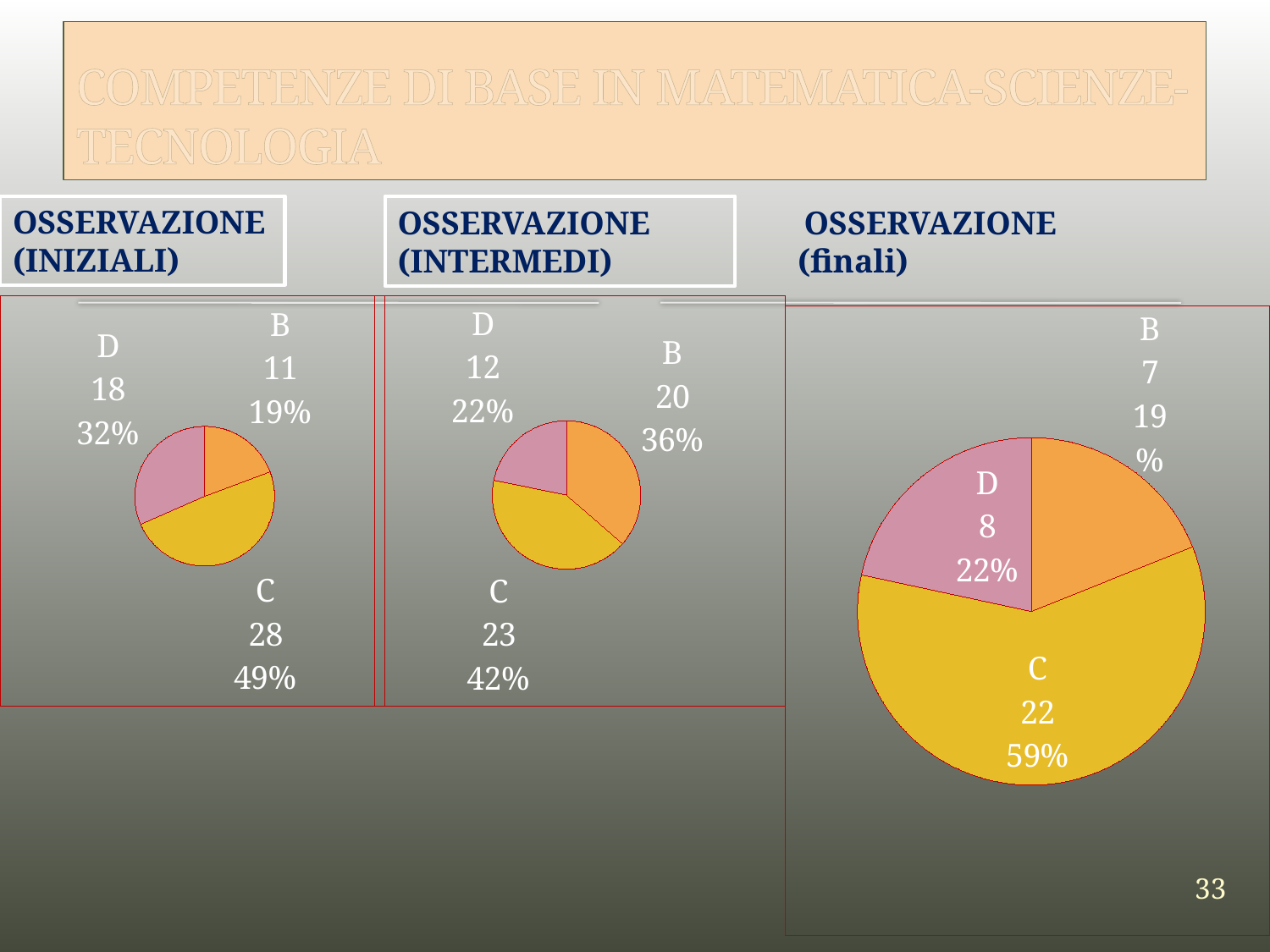
In the OSSERVAZIONE (INTERMEDI) pie chart, which is larger, the value for B or the value for D? B In the OSSERVAZIONE (finali) pie chart, which category has the smallest value? B In the OSSERVAZIONE (INTERMEDI) pie chart, what is the value for category B? 20 In the OSSERVAZIONE (INIZIALI) pie chart, what is the value for category C? 28 In the OSSERVAZIONE (INTERMEDI) pie chart, what share of the pie does category C have? 42% In the OSSERVAZIONE (finali) pie chart, what is the value for category D? 8 In the OSSERVAZIONE (INIZIALI) pie chart, what share of the pie does category D have? 32% In the OSSERVAZIONE (INIZIALI) pie chart, what is the difference between the values for C and D? 10 In the OSSERVAZIONE (INTERMEDI) pie chart, which category has the smallest slice? D In the OSSERVAZIONE (INIZIALI) pie chart, which category has the largest slice? C What kind of chart is used for the OSSERVAZIONE (finali) data? Pie chart In the OSSERVAZIONE (finali) pie chart, what share of the pie does category C have? 59%